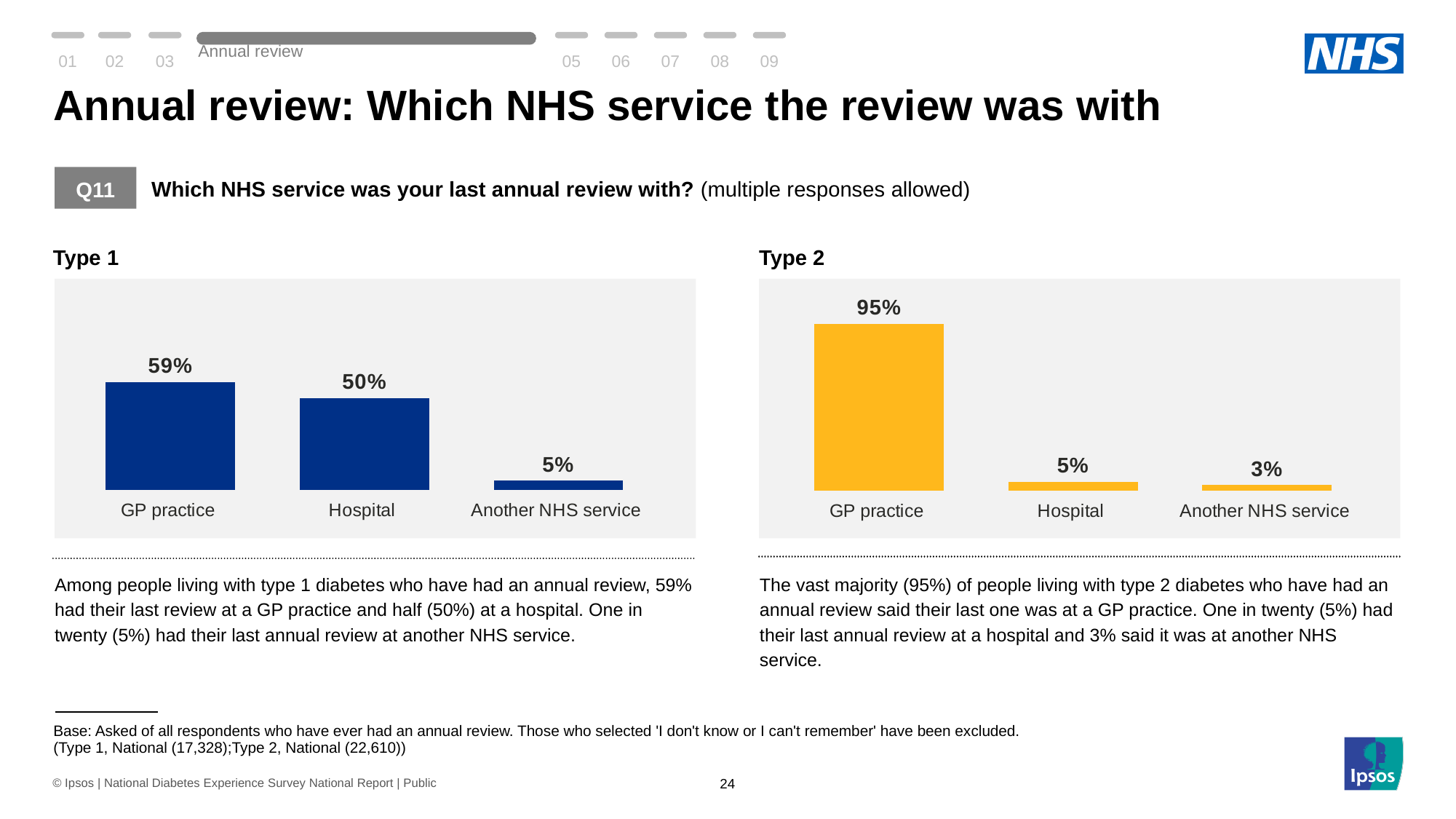
In the Type 2 chart, what percentage had their last annual review at a hospital? 5% In the Type 1 chart, what is the value for Another NHS service? 5% Which is larger: the Hospital value in the Type 1 chart or the Hospital value in the Type 2 chart? Type 1 In the Type 2 chart, do the values rise or fall from left to right? Fall In the Type 2 chart, which category has the highest value? GP practice In the Type 2 chart, what is the difference between the GP practice and Another NHS service values? 92 percentage points In the Type 1 chart, which category has the lowest value? Another NHS service How many categories are shown in the Type 2 chart? 3 In the Type 1 chart, what is the difference between the GP practice and Hospital values? 9 percentage points What colour are the bars in the Type 2 chart? Yellow In the Type 1 chart, what percentage had their last annual review at a GP practice? 59% What kind of chart is the Type 1 chart? Bar chart